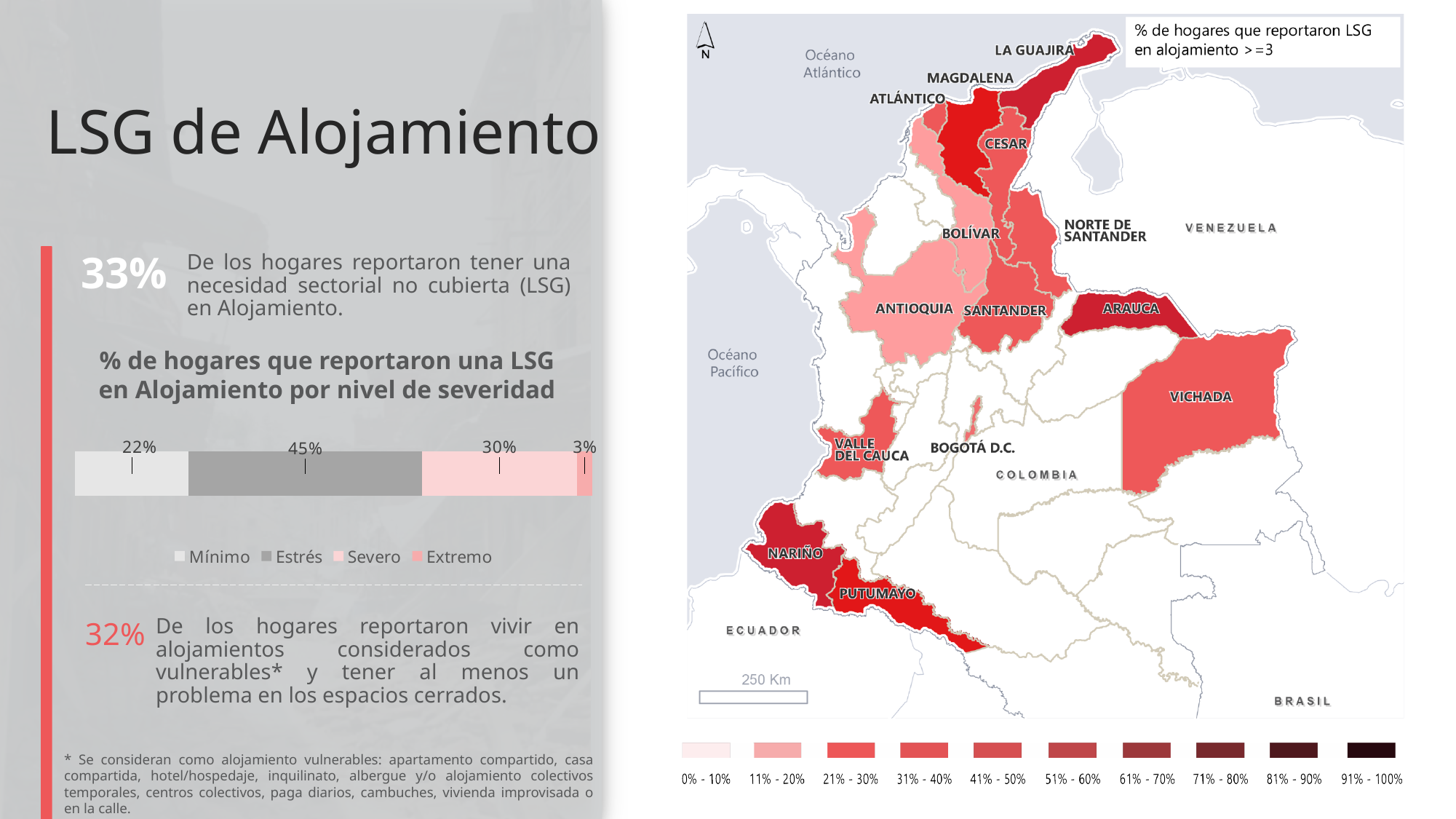
In the chart '% de hogares que reportaron una LSG en Alojamiento por nivel de severidad', what is the value for Estrés? 45% In the severity bar chart, which severity level has the lowest percentage? Extremo In the severity bar chart, what is the difference between the Estrés and Severo values? 15% In the severity bar chart, what is the total of the Mínimo and Estrés segments? 67% How many series does the legend of the severity bar chart list? 4 In the chart '% de hogares que reportaron una LSG en Alojamiento por nivel de severidad', what is the value for Mínimo? 22% In the chart '% de hogares que reportaron una LSG en Alojamiento por nivel de severidad', what is the value for Extremo? 3% What kind of chart is used to show '% de hogares que reportaron una LSG en Alojamiento por nivel de severidad'? Stacked bar chart In the severity bar chart, which severity level has the highest percentage? Estrés In the severity bar chart, which is larger, Mínimo or Severo? Severo In the chart '% de hogares que reportaron una LSG en Alojamiento por nivel de severidad', what is the value for Severo? 30% In the severity bar chart, which legend entry is shown in dark grey? Estrés